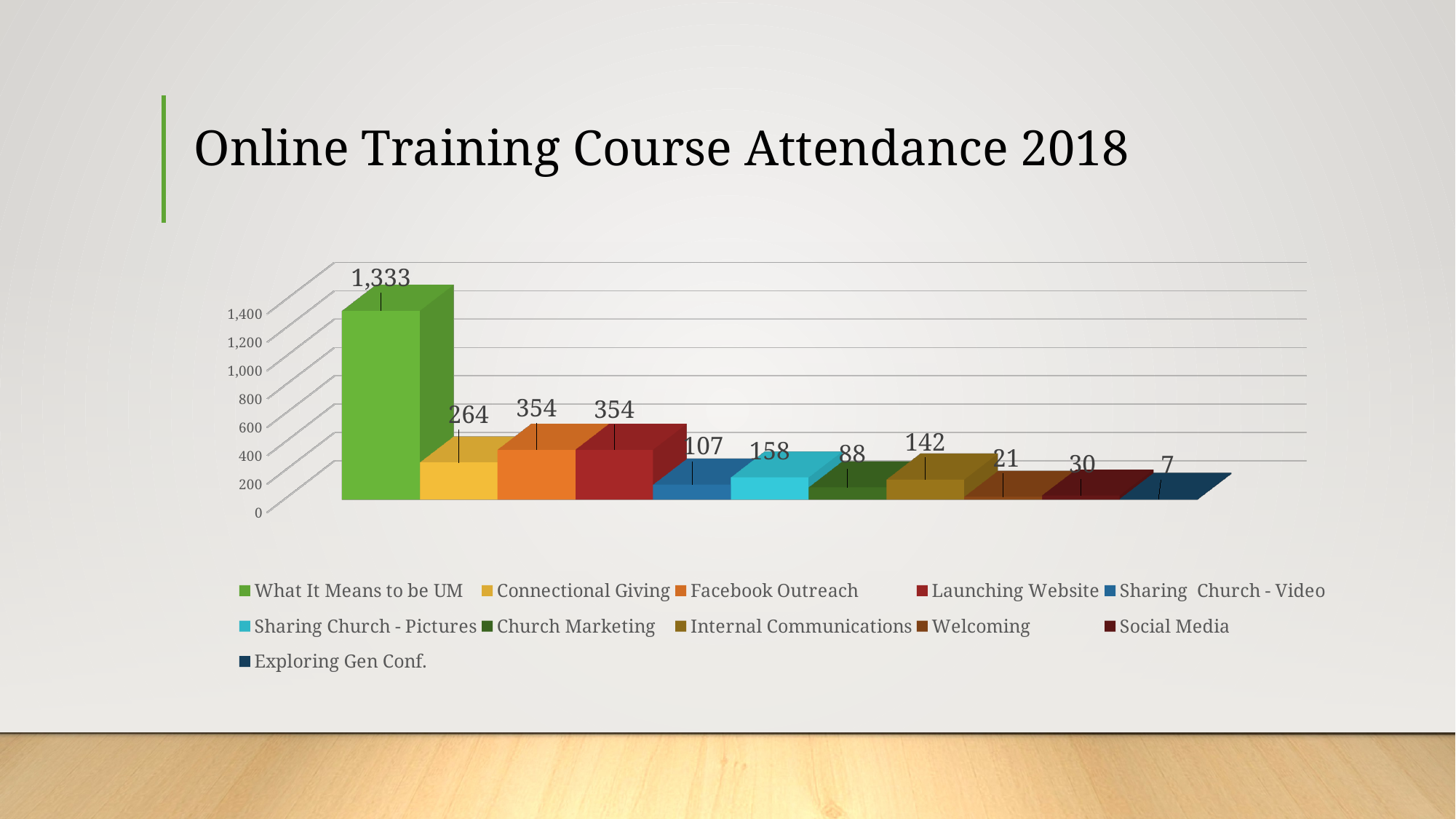
What type of chart is shown on the slide? Bar chart What is the attendance value for Connectional Giving? 264 What is the attendance value for What It Means to be UM? 1,333 What is the difference between the attendance for What It Means to be UM and Facebook Outreach? 979 What is the attendance value for Exploring Gen Conf.? 7 Which has higher attendance, Sharing Church - Video or Sharing Church - Pictures? Sharing Church - Pictures What is the difference between the attendance for Internal Communications and Church Marketing? 54 Which course has the highest attendance? What It Means to be UM How many bars are plotted in the chart? 11 Which course has the lowest attendance? Exploring Gen Conf. What is the attendance value for Sharing Church - Pictures? 158 How many entries does the legend list? 11